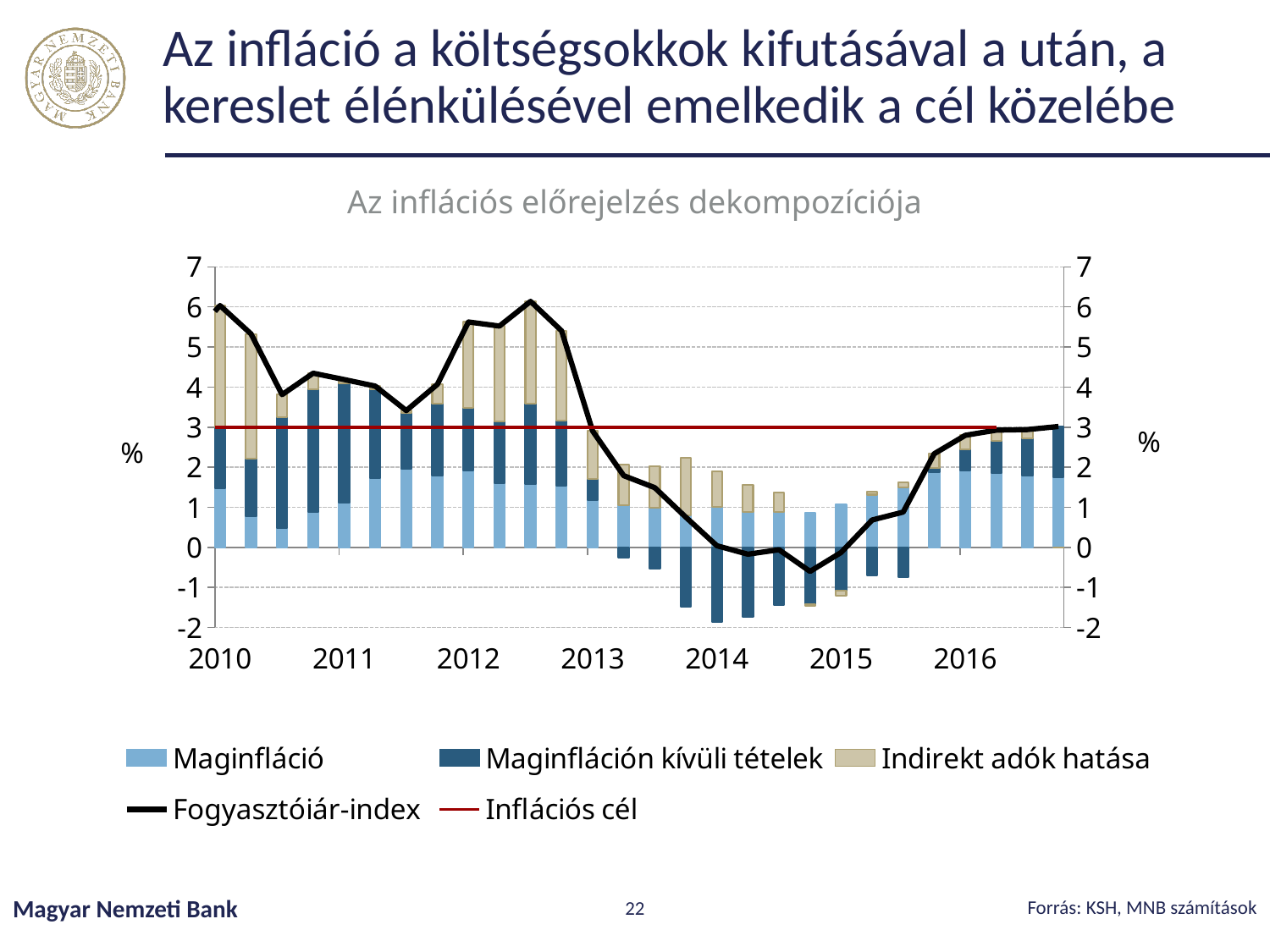
Which is larger, the Fogyasztóiár-index at the 2010 tick or at the 2014 tick? 2010 Between the 2015 and 2016 ticks, does the Fogyasztóiár-index line rise or fall? rise Is the Maginfláció value in the first bar of 2010 greater or less than 1? greater What kind of chart is shown on the slide? Stacked bar chart with line series Between the 2013 and 2014 ticks, does the Fogyasztóiár-index line rise or fall? fall Is the Fogyasztóiár-index value at the 2011 tick greater or less than 3? greater Which series is drawn as the thick black line? Fogyasztóiár-index What is the title of the chart? Az inflációs előrejelzés dekompozíciója How many year labels are shown on the x axis? 7 Is the lowest point of the Fogyasztóiár-index line greater or less than 0? less How many series does the legend list? 5 At what value on the axis does the Inflációs cél line sit? 3